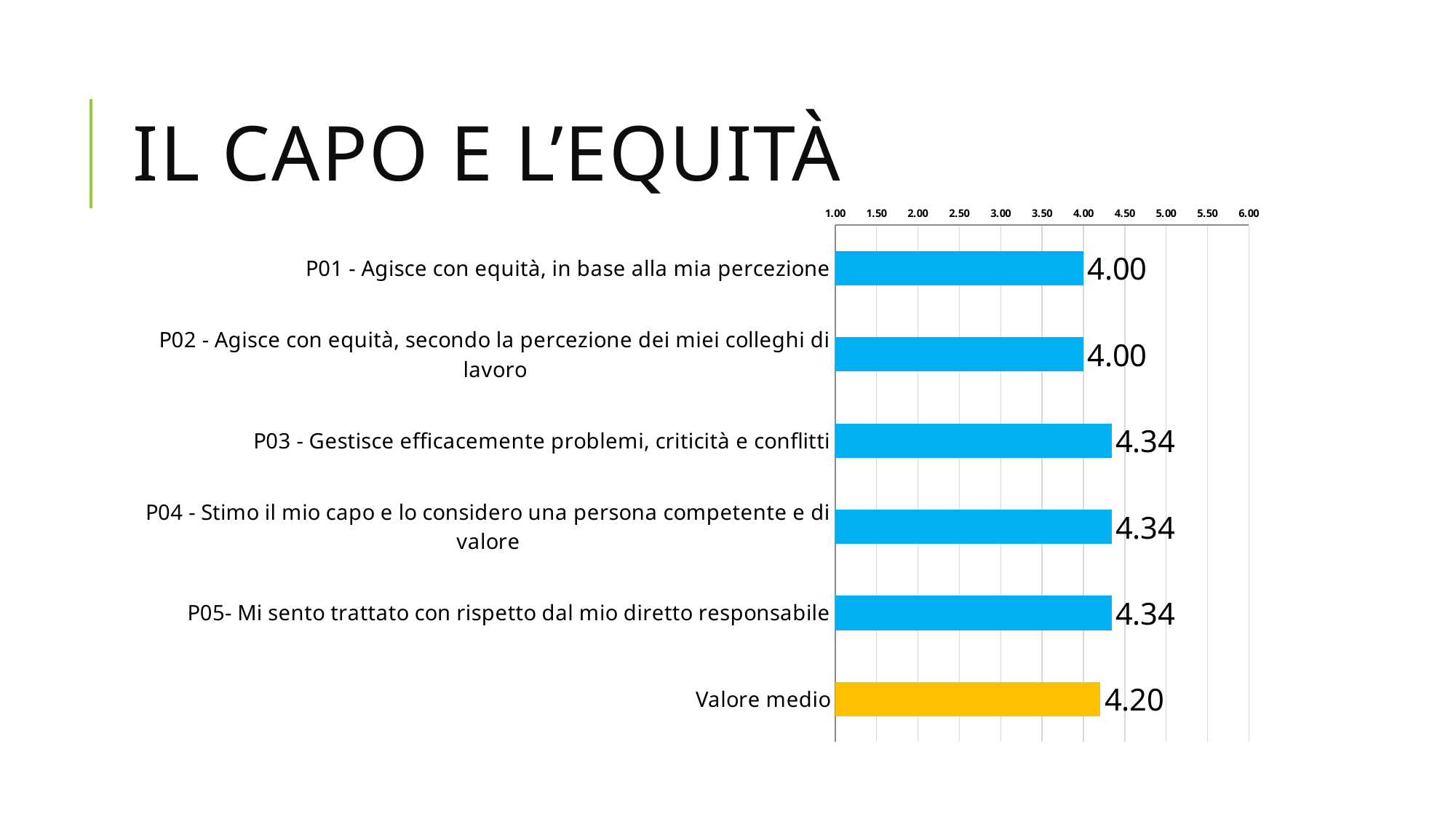
What kind of chart is shown on the slide? Bar chart What is the value for P03 - Gestisce efficacemente problemi, criticità e conflitti? 4.34 What is the value for P01 - Agisce con equità, in base alla mia percezione? 4.00 What is the value for Valore medio? 4.20 What is the value for P05- Mi sento trattato con rispetto dal mio diretto responsabile? 4.34 Which category has the lowest value among P01 to P05? P01 and P02 (both 4.00) Which is larger, the value for P02 or the value for Valore medio? Valore medio What is the difference between the value for P04 and Valore medio? 0.14 What is the difference between the value for P03 and the value for P01? 0.34 Is the value for P05 greater or less than 4.50? less How many bars are shown in the chart? 6 Which bar is shown in a different colour (orange) from the others? Valore medio